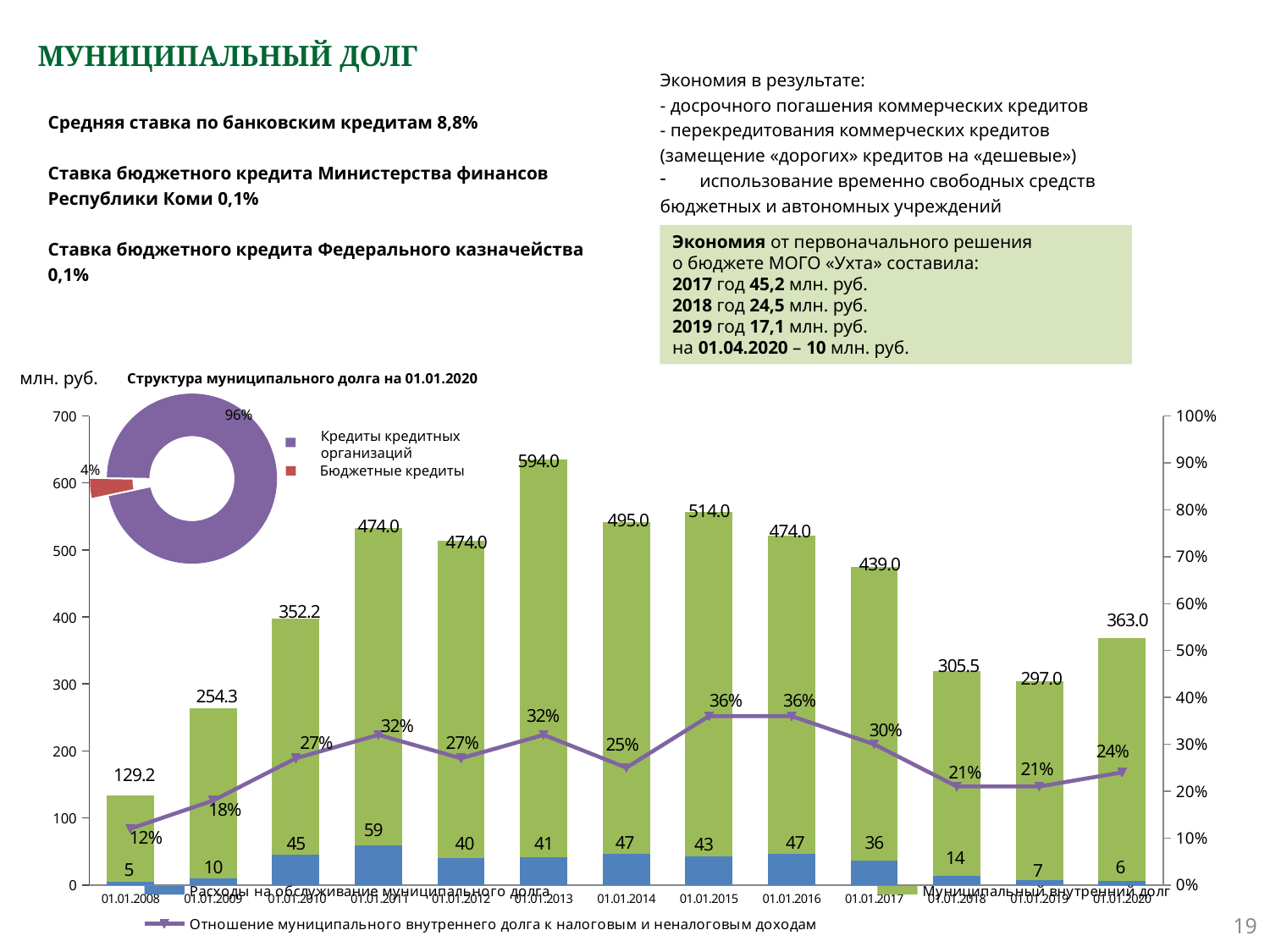
In the large bar chart at the bottom, how many dates are shown on the x axis? 13 In the large bar chart at the bottom, what is the value of 'Муниципальный внутренний долг' on 01.01.2013? 594.0 In the large bar chart at the bottom, by how much does 'Муниципальный внутренний долг' on 01.01.2020 exceed the value on 01.01.2019? 66.0 In the large bar chart at the bottom, how many series does the legend list? 3 In the chart 'Структура муниципального долга на 01.01.2020', what share is 'Кредиты кредитных организаций'? 96% In the large bar chart at the bottom, on which date is 'Муниципальный внутренний долг' highest? 01.01.2013 In the chart 'Структура муниципального долга на 01.01.2020', what share is 'Бюджетные кредиты'? 4% In the chart 'Структура муниципального долга на 01.01.2020', what kind of chart is it? Doughnut (pie) chart In the large bar chart at the bottom, what is the value of 'Расходы на обслуживание муниципального долга' on 01.01.2011? 59 In the large bar chart at the bottom, what is the value of 'Отношение муниципального внутреннего долга к налоговым и неналоговым доходам' on 01.01.2015? 36% In the large bar chart at the bottom, which is larger for 'Муниципальный внутренний долг': 01.01.2014 or 01.01.2015? 01.01.2015 In the large bar chart at the bottom, on which date is 'Муниципальный внутренний долг' lowest? 01.01.2008